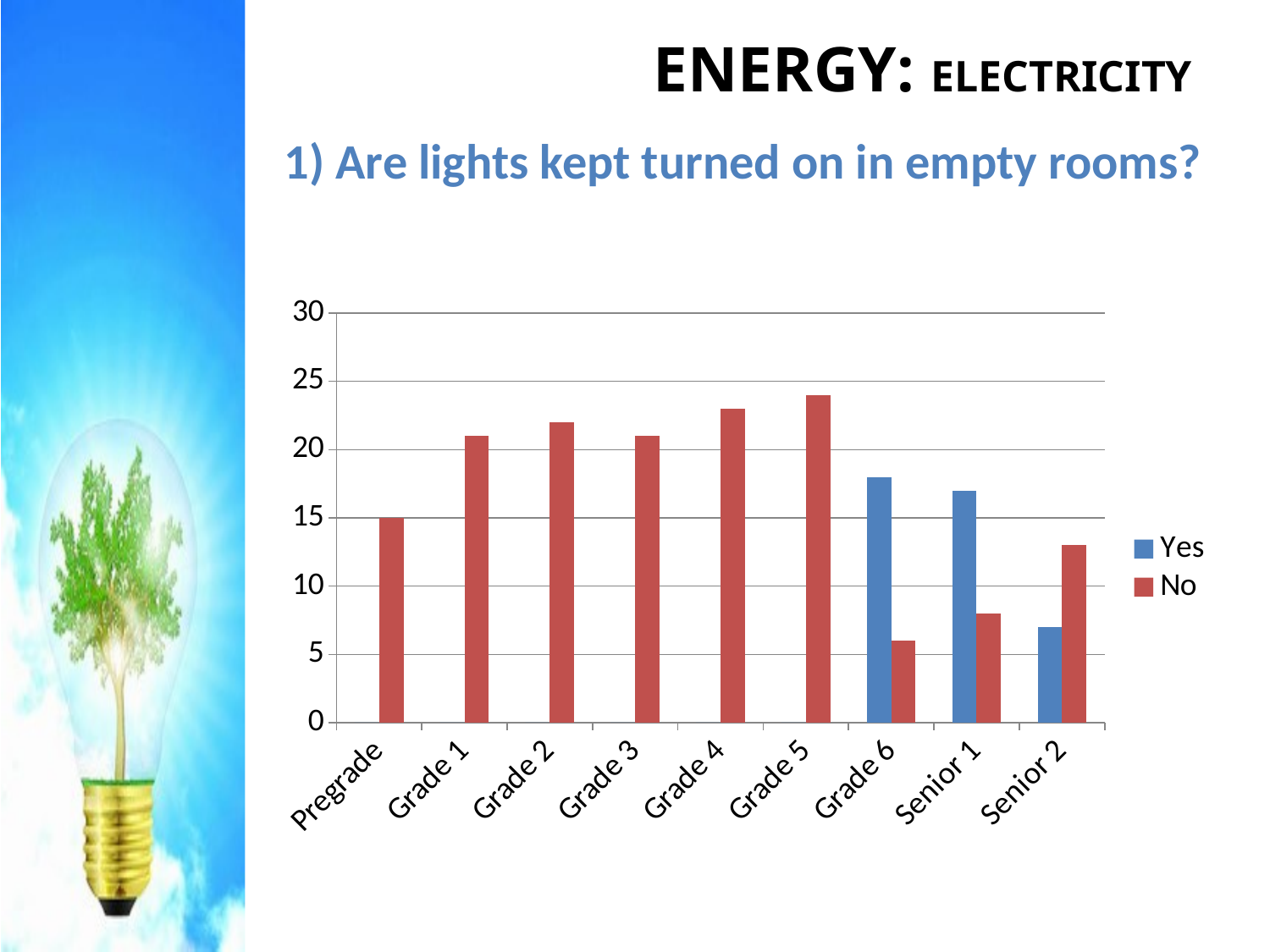
What colour are the No bars in the chart? red How many series does the legend list? 2 Is the No value for Grade 5 greater or less than 20? greater How many grade categories are shown on the x axis? 9 Is the Yes value for Senior 2 greater or less than 10? less Which category has the shortest No bar? Grade 6 For Senior 2, which is larger, the Yes bar or the No bar? No Which category has the tallest No bar? Grade 5 For Grade 6, which is larger, the Yes bar or the No bar? Yes What is the value of the No bar for Pregrade? 15 Is the No value for Grade 6 greater or less than 10? less What kind of chart is shown on the slide? bar chart